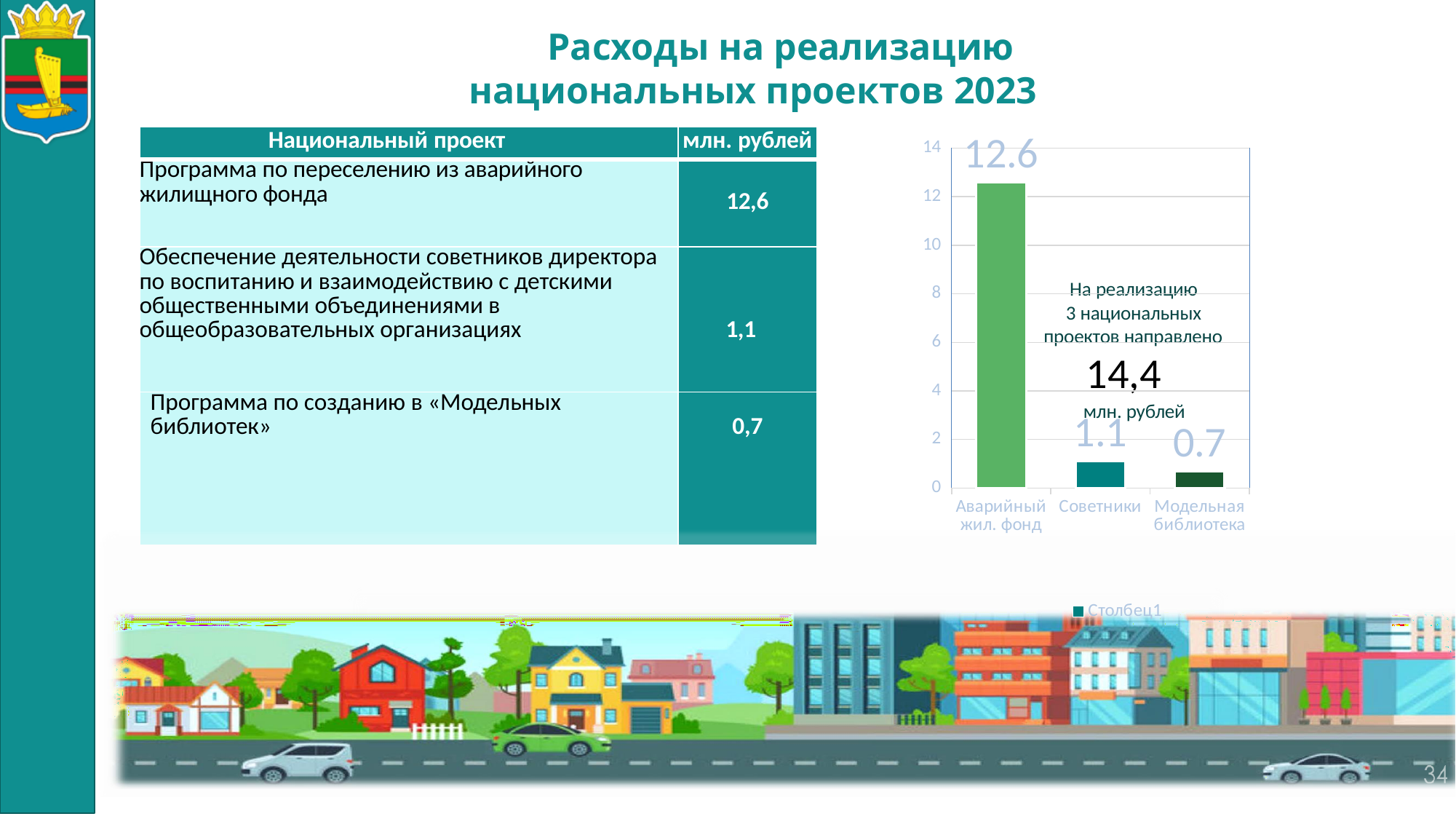
What kind of chart is shown on the slide? bar chart What is the value for Аварийный жил. фонд in the bar chart? 12.6 Which is larger, the value for Советники or the value for Модельная библиотека? Советники Which category has the lowest value in the bar chart? Модельная библиотека Is the value for Аварийный жил. фонд greater or less than 10? greater What is the legend entry shown below the bar chart? Столбец1 Which category has the highest value in the bar chart? Аварийный жил. фонд What is the difference between the values for Советники and Модельная библиотека? 0.4 How many categories are shown in the bar chart? 3 What is the value for Модельная библиотека in the bar chart? 0.7 What is the value for Советники in the bar chart? 1.1 What is the difference between the values for Аварийный жил. фонд and Советники? 11.5